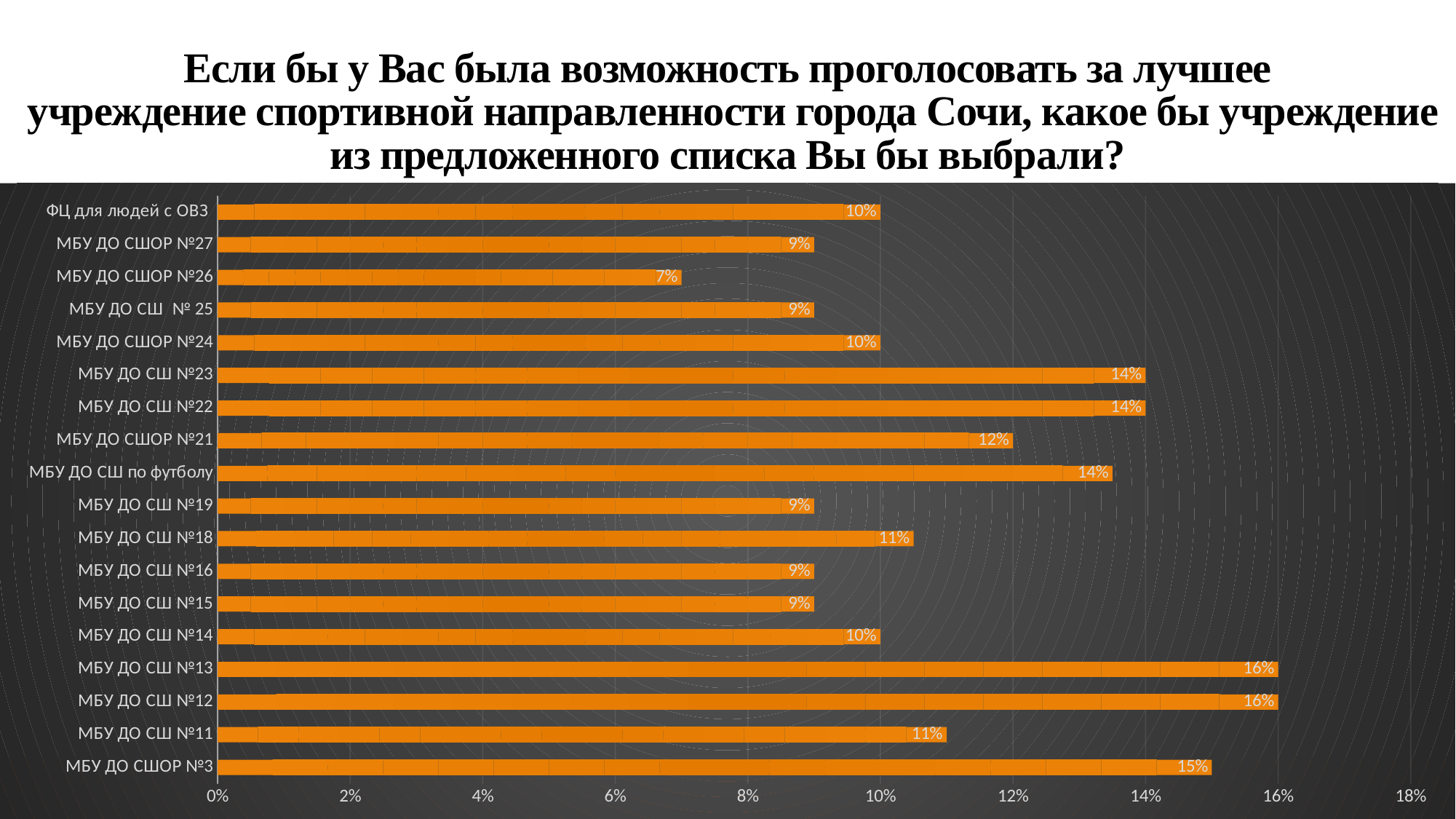
How many institutions (categories) are listed in the chart? 18 Which institution has the lowest value in the chart? МБУ ДО СШОР №26 Is the value for МБУ ДО СШ №12 greater or less than 14%? greater Which has a larger value, МБУ ДО СШ №23 or МБУ ДО СШ №19? МБУ ДО СШ №23 What is the difference between the values for МБУ ДО СШ №11 and МБУ ДО СШ №15? 2% What kind of chart is shown on the slide? bar chart What is the value for МБУ ДО СШОР №3? 15% What is the highest value shown on the horizontal axis of the chart? 18% What is the value for МБУ ДО СШОР №21? 12% What is the value for МБУ ДО СШ по футболу? 14% What is the difference between the values for МБУ ДО СШ №13 and МБУ ДО СШОР №26? 9% What is the value for ФЦ для людей с ОВЗ? 10%